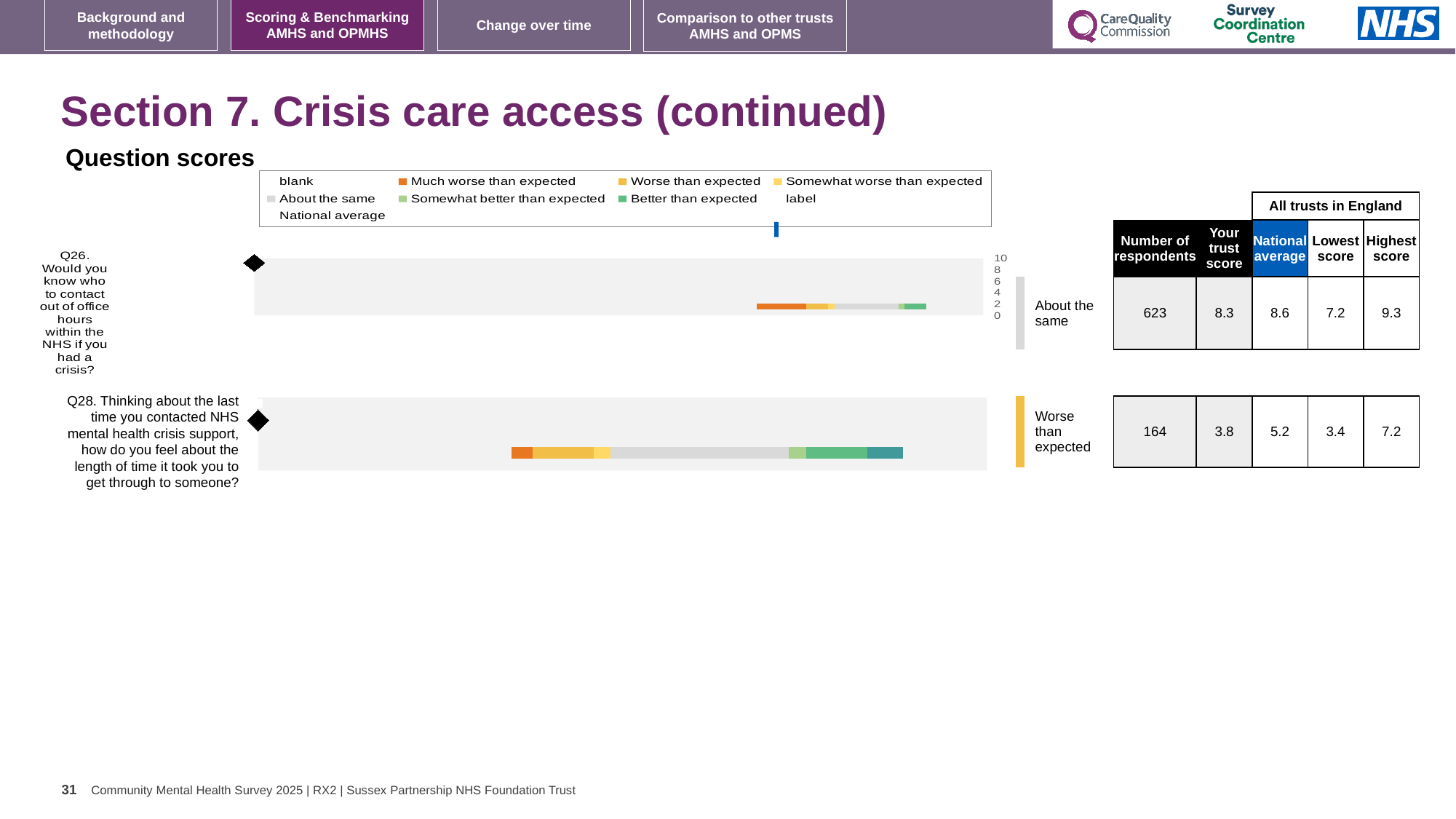
What rating label is shown next to the bar for Q26 (knowing who to contact out of office hours)? About the same How many survey questions are plotted in the Question scores chart? 2 What is the highest score among all trusts in England for Q28? 7.2 What is the lowest score among all trusts in England for Q26? 7.2 What is the trust's score for Q26? 8.3 How many respondents are listed for Q26? 623 What is the national average score for Q28? 5.2 Which colour in the legend represents 'Much worse than expected'? orange By how much is the national average for Q28 higher than the trust's score for Q28? 1.4 What kind of chart is used for the Question scores? bar chart Which question has the higher trust score, Q26 or Q28? Q26 What rating label is shown next to the bar for Q28 (length of time to get through to someone)? Worse than expected